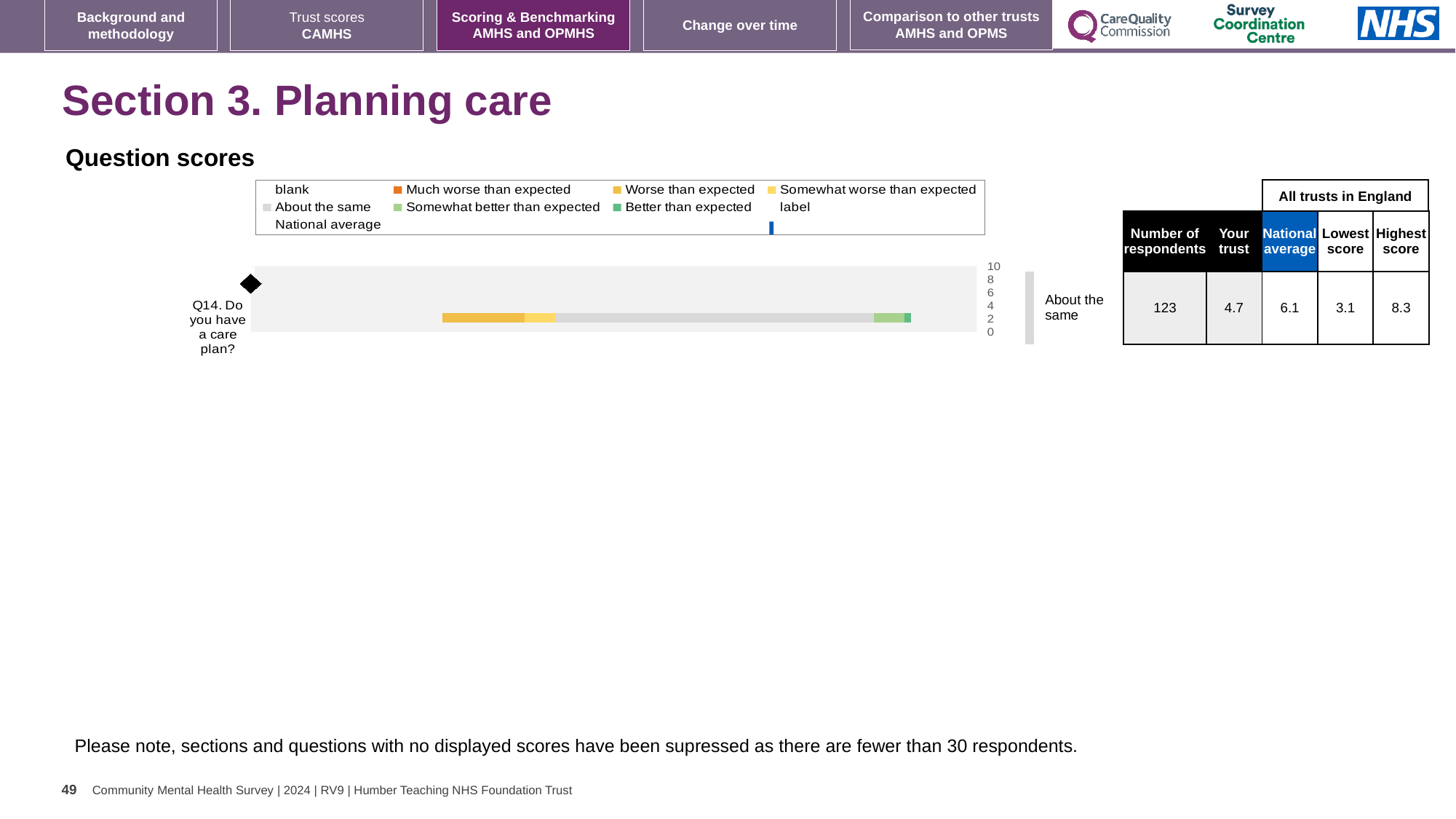
Which question is plotted in the Question scores chart? Q14. Do you have a care plan? What kind of chart is shown under 'Question scores'? bar chart What is the highest value shown on the chart's axis? 10 What benchmark category label is shown to the right of the bar for Q14? About the same How many questions are plotted in the Question scores chart? 1 According to the table beside the chart, what is the 'Your trust' score for Q14? 4.7 According to the table beside the chart, what is the lowest score among all trusts in England for Q14? 3.1 According to the table beside the chart, what is the national average score for Q14? 6.1 Which is larger for Q14, the 'Your trust' score or the national average? National average According to the table beside the chart, what is the highest score among all trusts in England for Q14? 8.3 What is the difference between the highest score and the lowest score for Q14 in the table beside the chart? 5.2 According to the table beside the chart, how many respondents answered Q14? 123